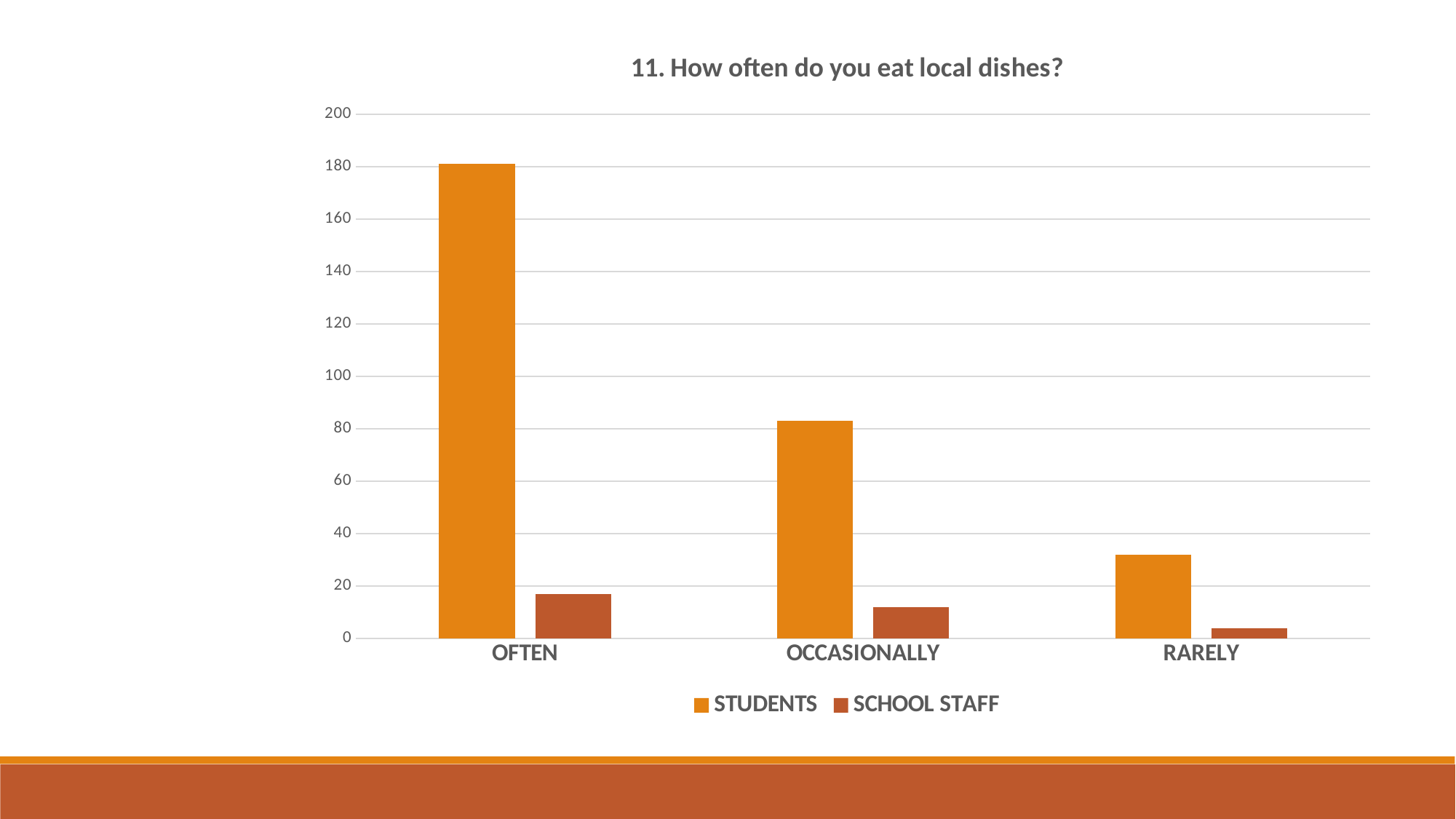
Is the STUDENTS value for OCCASIONALLY greater or less than 100? less How many series does the legend list? 2 Which is larger for OCCASIONALLY, the STUDENTS value or the SCHOOL STAFF value? STUDENTS Which category has the highest value for STUDENTS? OFTEN What type of chart is shown on the slide? bar chart Is the STUDENTS value for RARELY greater or less than 40? less Is the STUDENTS value for OFTEN greater or less than 160? greater Which category has the lowest value for SCHOOL STAFF? RARELY What is the title of the chart? 11. How often do you eat local dishes? Do the STUDENTS values rise or fall from OFTEN to RARELY along the x axis? fall How many categories are shown on the x axis? 3